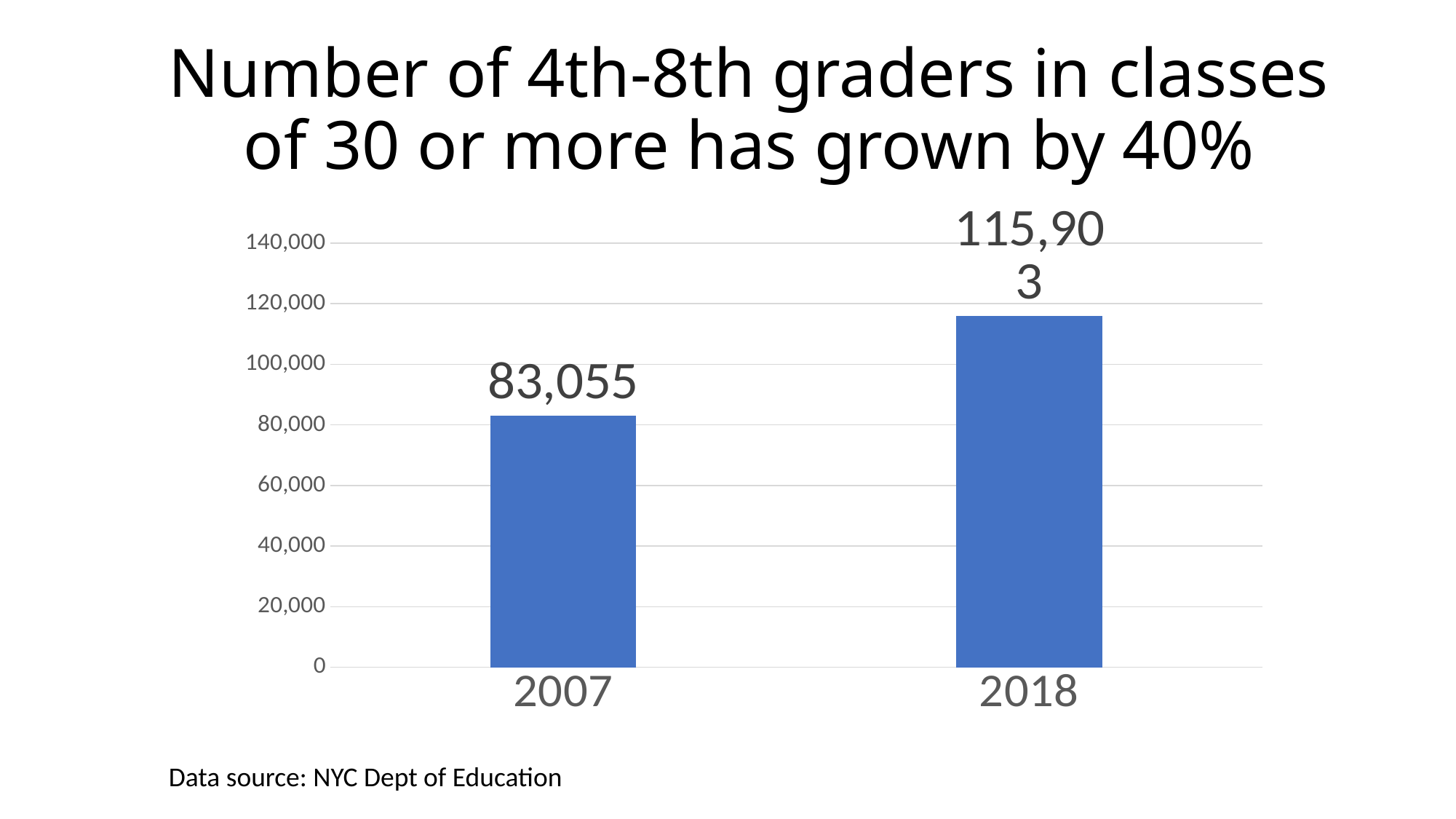
What is the value for 2007? 83,055 What kind of chart is shown on the slide? bar chart How many bars are shown in the chart? 2 What data source is cited on the slide? NYC Dept of Education Is the value for 2007 larger or smaller than the value for 2018? smaller What is the value for 2018? 115,903 Is the value for 2018 greater or less than 100,000? greater Which year has the higher value? 2018 Do the values rise or fall from 2007 to 2018? rise Is the value for 2007 greater or less than 100,000? less What is the difference between the values for 2018 and 2007? 32,848 Which year has the lower value? 2007